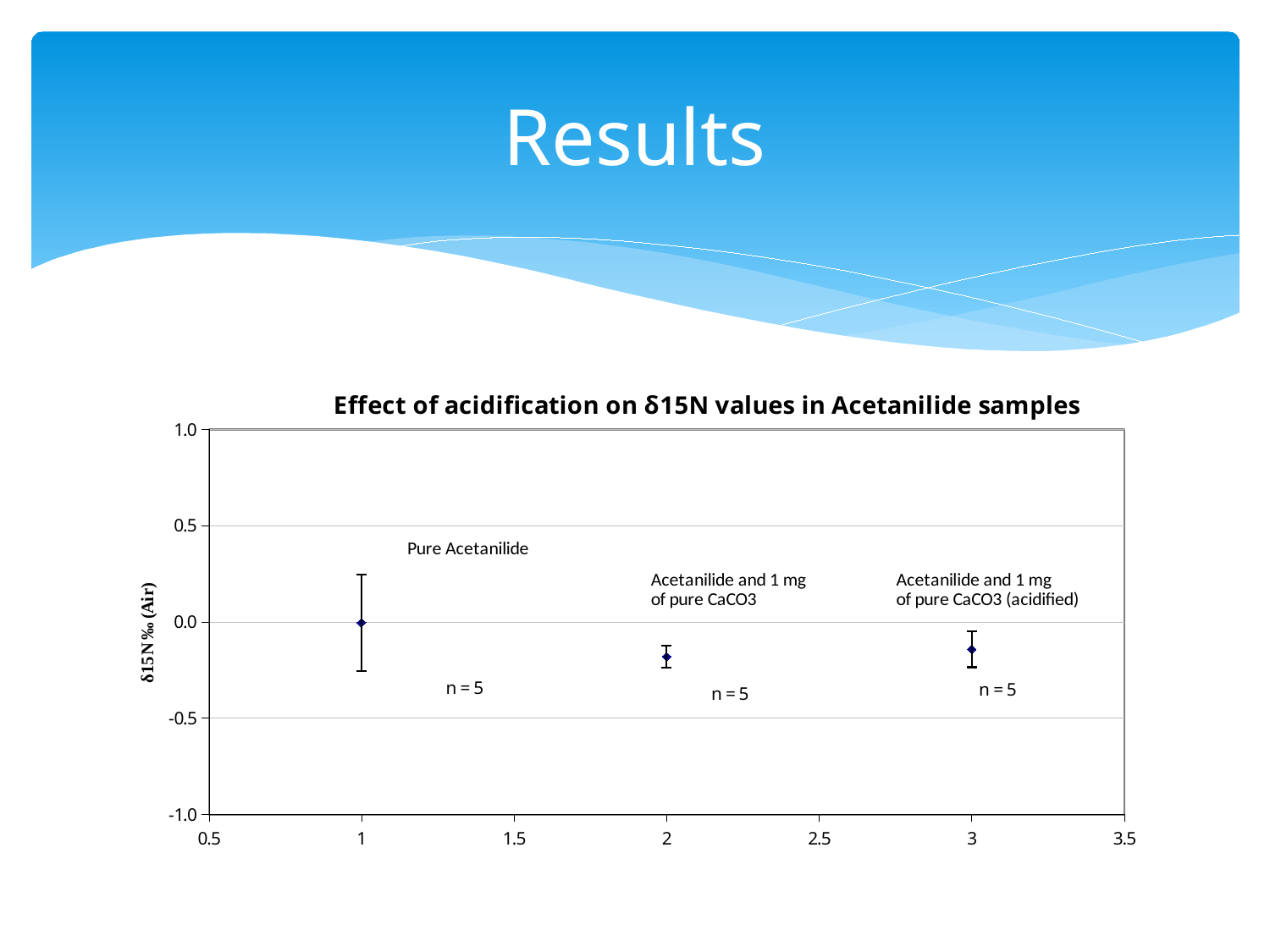
What type of chart is shown on the slide? Scatter chart Is the δ15N value for Acetanilide and 1 mg of pure CaCO3 greater or less than 0.0? less Is the δ15N value for Acetanilide and 1 mg of pure CaCO3 (acidified) greater or less than -0.5? greater How many data points are plotted in the chart? 3 Is the δ15N value for Acetanilide and 1 mg of pure CaCO3 (acidified) greater or less than 0.0? less Which is larger, the δ15N value for Pure Acetanilide or for Acetanilide and 1 mg of pure CaCO3? Pure Acetanilide What is the sample size (n) shown for each of the three samples? n = 5 Which sample has the highest δ15N value? Pure Acetanilide What is the title of the chart? Effect of acidification on δ15N values in Acetanilide samples